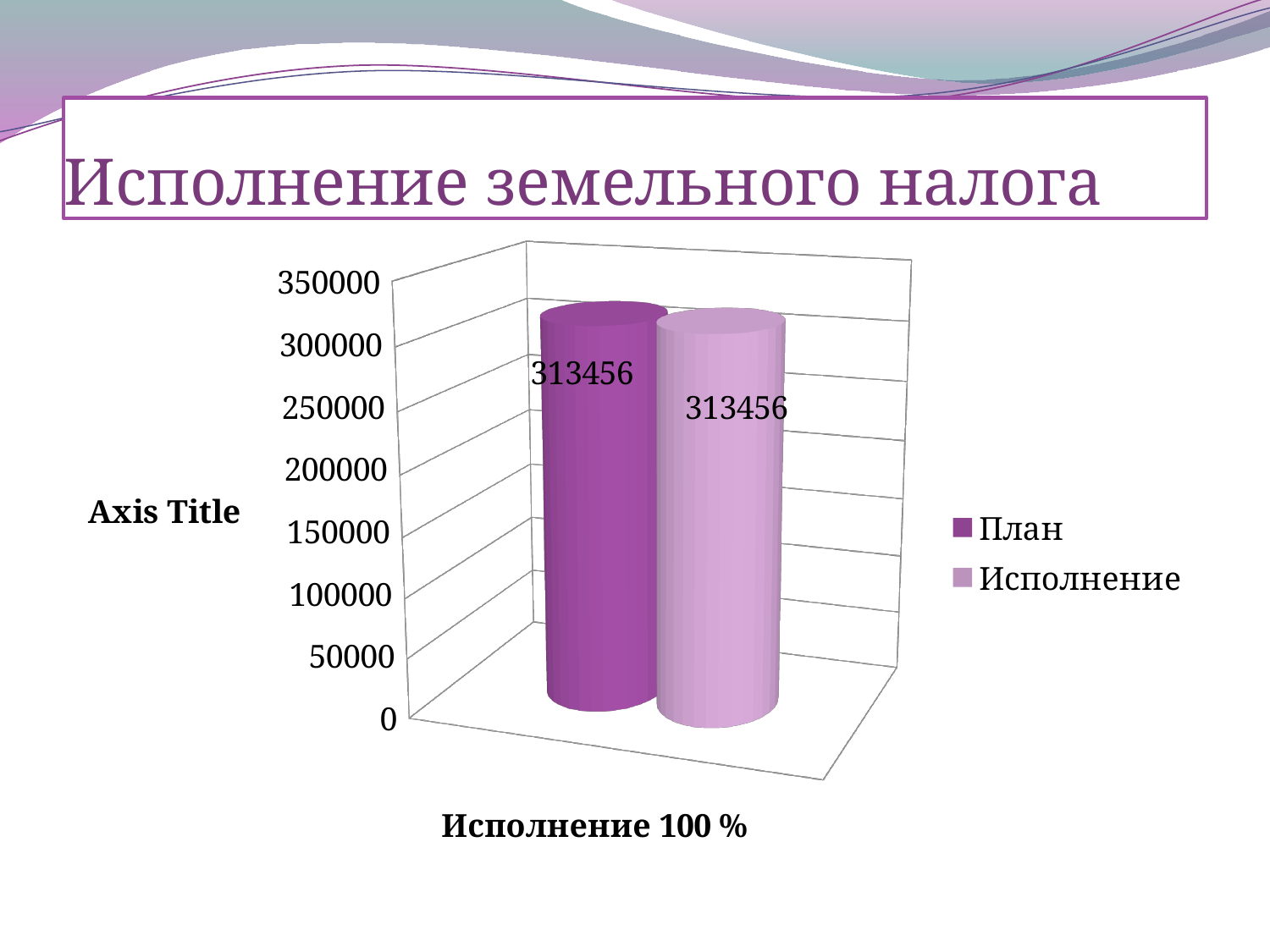
Is the value for Исполнение greater or less than 350000? less What is the value for План? 313456 How many series does the legend list? 2 What is the difference between the План value and the Исполнение value? 0 What is the label shown below the horizontal axis of the chart? Исполнение 100 % What is the title of the slide? Исполнение земельного налога Is the value for План greater or less than 300000? greater How many bars are plotted in the chart? 2 What is the value for Исполнение? 313456 What kind of chart is shown on the slide? bar chart What is the highest tick value shown on the vertical axis? 350000